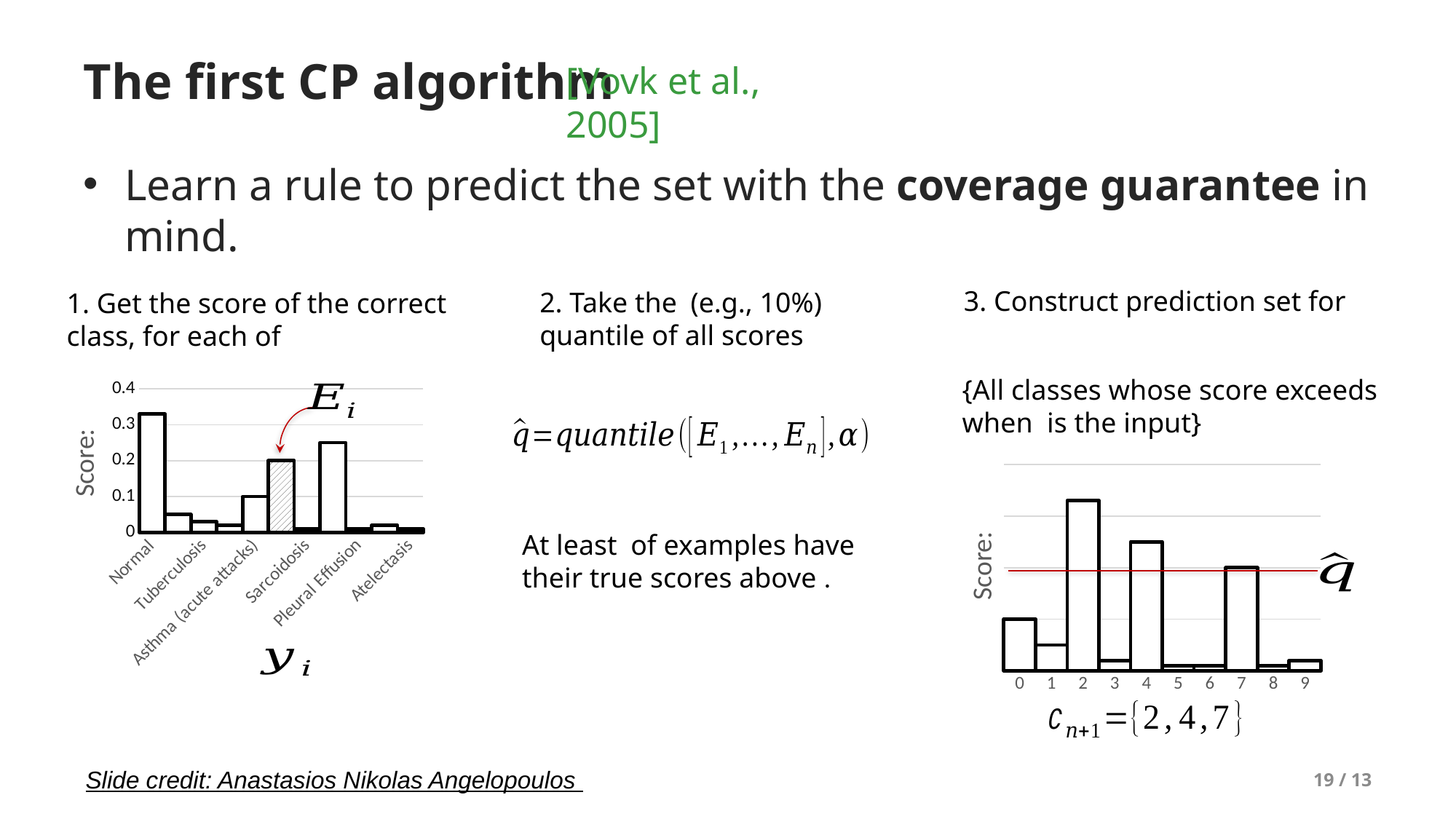
In the left chart, what is the highest value shown on the Score axis? 0.4 In the left chart, which category has the highest score? Normal In the right chart, which has the larger score, class 4 or class 7? class 4 In the right chart, what does the red horizontal line represent? q̂ (the quantile threshold) In the right chart, how many bars exceed the red horizontal line? 3 In the right chart, which has the larger score, class 0 or class 1? class 0 What kind of chart is the left chart (Score by class)? bar chart In the left chart, is the value for Normal greater or less than 0.4? less In the right chart, which class has the highest score? 2 In the right chart, how many classes are shown on the x axis? 10 What kind of chart is the right chart (classes 0 to 9)? bar chart In the left chart, is the value for Normal greater or less than 0.3? greater